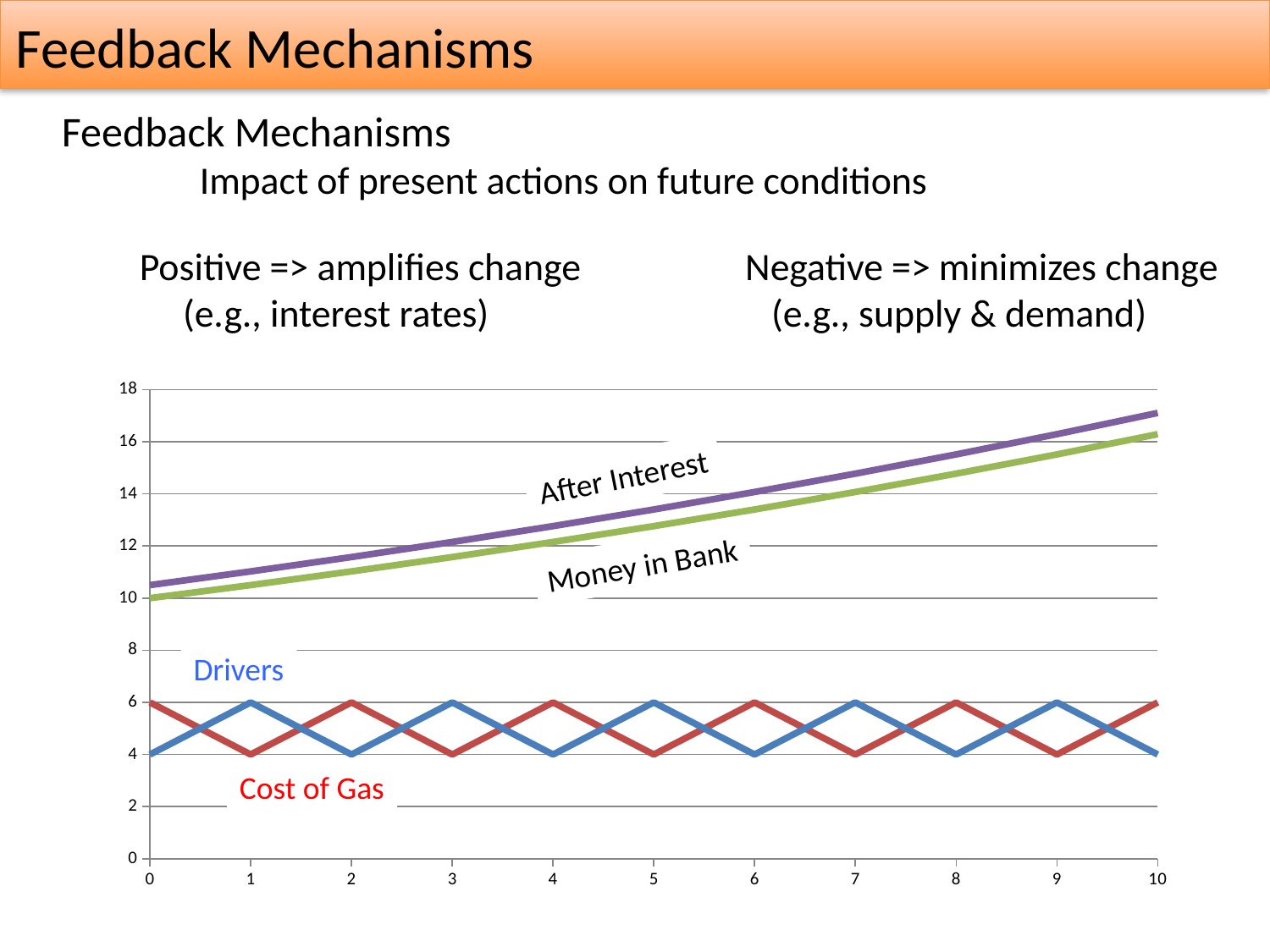
How many lines are plotted on the chart? 4 What kind of chart is shown on the slide? line chart What is the difference between the Drivers value at x = 1 and at x = 0? 2 What is the value of the Money in Bank line at x = 0? 10 What is the value of the Cost of Gas line at x = 0? 6 Does the Money in Bank line rise or fall as x increases from 0 to 10? rises Is the value of the After Interest line at x = 0 greater or less than 12? less Is the value of the After Interest line at x = 10 greater or less than 16? greater At x = 10, which line is higher: After Interest or Money in Bank? After Interest What is the value of the Drivers line at x = 1? 6 What is the lowest value reached by the Drivers line? 4 What colour is the Cost of Gas line? red